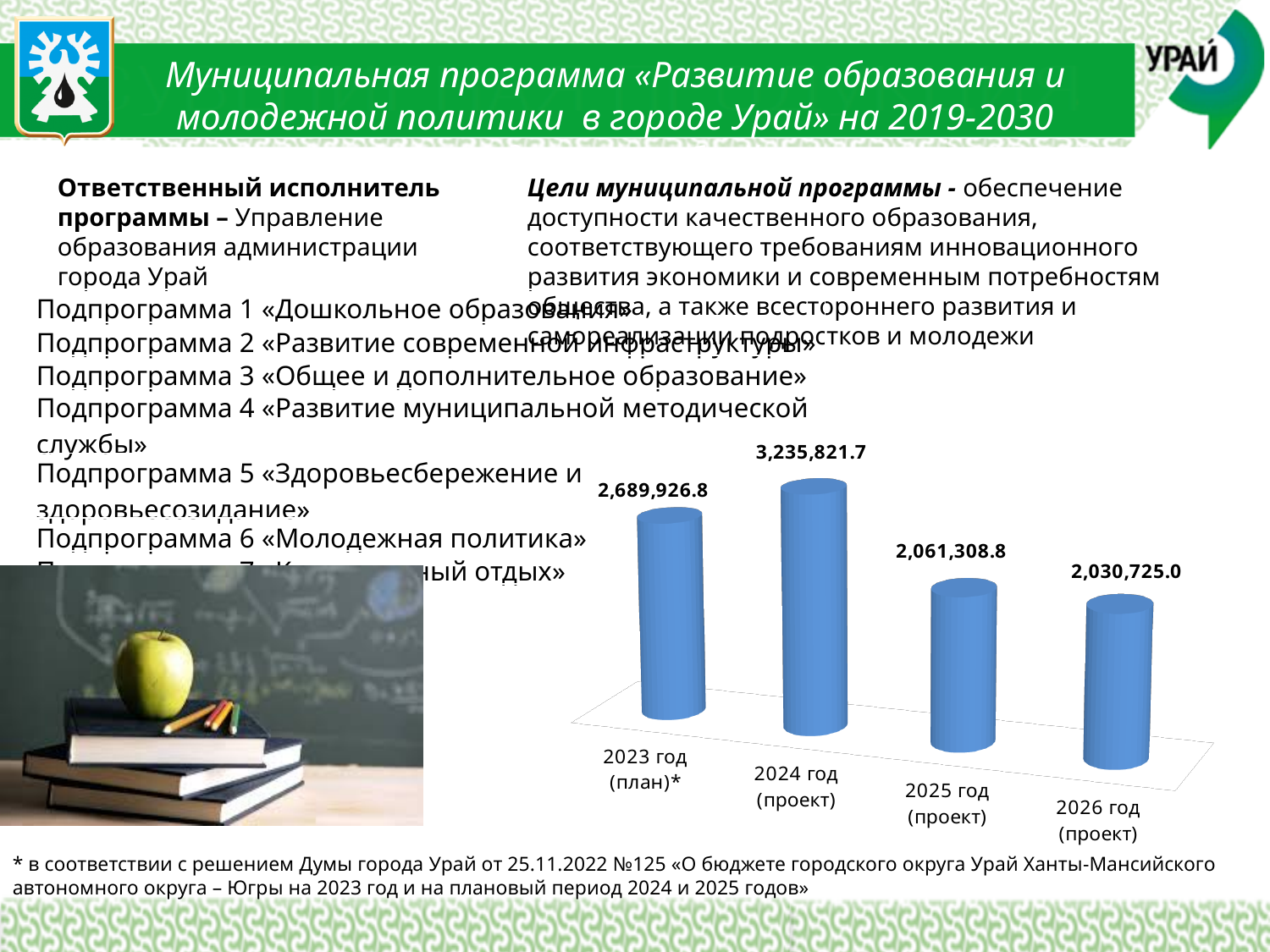
Do the values rise or fall from 2024 год (проект) to 2026 год (проект)? Fall Which year has the lowest value in the chart? 2026 год (проект) How many categories (years) are shown in the chart? 4 What is the difference between the values for 2025 год (проект) and 2026 год (проект)? 30,583.8 What kind of chart is shown on the slide? Bar chart What is the difference between the values for 2024 год (проект) and 2023 год (план)*? 545,894.9 What is the value shown for 2024 год (проект)? 3,235,821.7 What is the value shown for 2025 год (проект)? 2,061,308.8 What is the value shown for 2023 год (план)*? 2,689,926.8 What is the value shown for 2026 год (проект)? 2,030,725.0 Which is larger: the value for 2023 год (план)* or the value for 2025 год (проект)? 2023 год (план)* Which year has the highest value in the chart? 2024 год (проект)